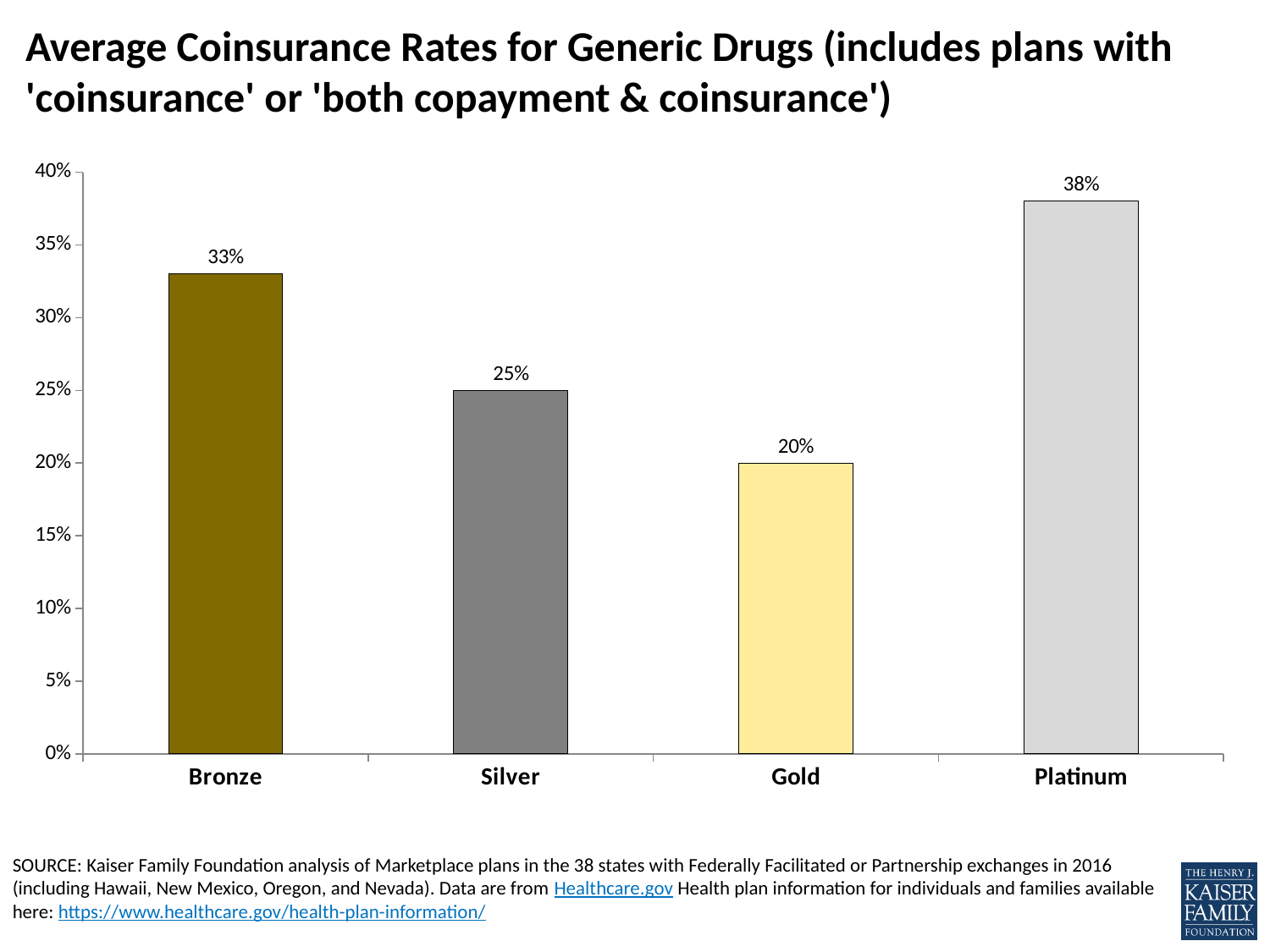
What is the average coinsurance rate for generic drugs for Gold plans? 20% What is the average coinsurance rate for generic drugs for Platinum plans? 38% Which plan tier has the lowest average coinsurance rate for generic drugs? Gold Is the value for Platinum greater or less than 35%? greater What is the difference between the Bronze and Silver average coinsurance rates? 8% What is the difference between the Platinum and Gold average coinsurance rates? 18% What is the average coinsurance rate for generic drugs for Bronze plans? 33% What kind of chart is shown on the slide? Bar chart What is the average coinsurance rate for generic drugs for Silver plans? 25% Which has a higher average coinsurance rate, Bronze or Silver? Bronze Which plan tier has the highest average coinsurance rate for generic drugs? Platinum How many plan tiers are shown on the chart? 4